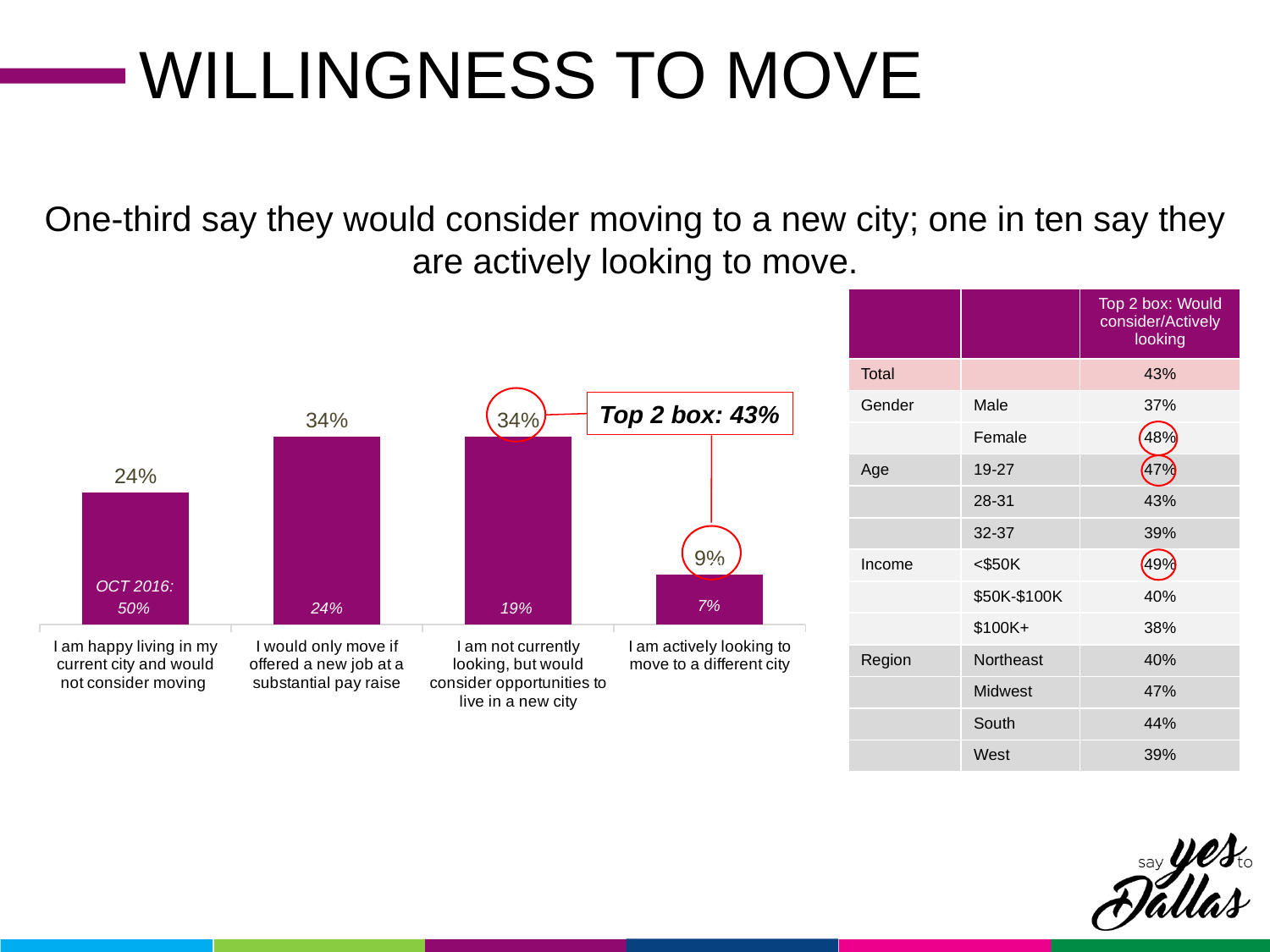
What was the OCT 2016 value for 'I am actively looking to move to a different city'? 7% What kind of chart is shown on the slide? Bar chart What percentage say they would only move if offered a new job at a substantial pay raise? 34% How many categories are shown in the bar chart? 4 What is the difference between the value for 'I would only move if offered a new job at a substantial pay raise' and the value for 'I am happy living in my current city and would not consider moving'? 10 percentage points What was the OCT 2016 value for 'I am happy living in my current city and would not consider moving'? 50% Which is larger: the value for 'I am happy living in my current city and would not consider moving' or the value for 'I am actively looking to move to a different city'? I am happy living in my current city and would not consider moving What is the difference between the value for 'I am not currently looking, but would consider opportunities to live in a new city' and the value for 'I am actively looking to move to a different city'? 25 percentage points What percentage say they are actively looking to move to a different city? 9% Which category has the lowest value in the bar chart? I am actively looking to move to a different city What percentage say they are happy living in their current city and would not consider moving? 24% What is the Top 2 box value shown in the annotation on the bar chart? 43%